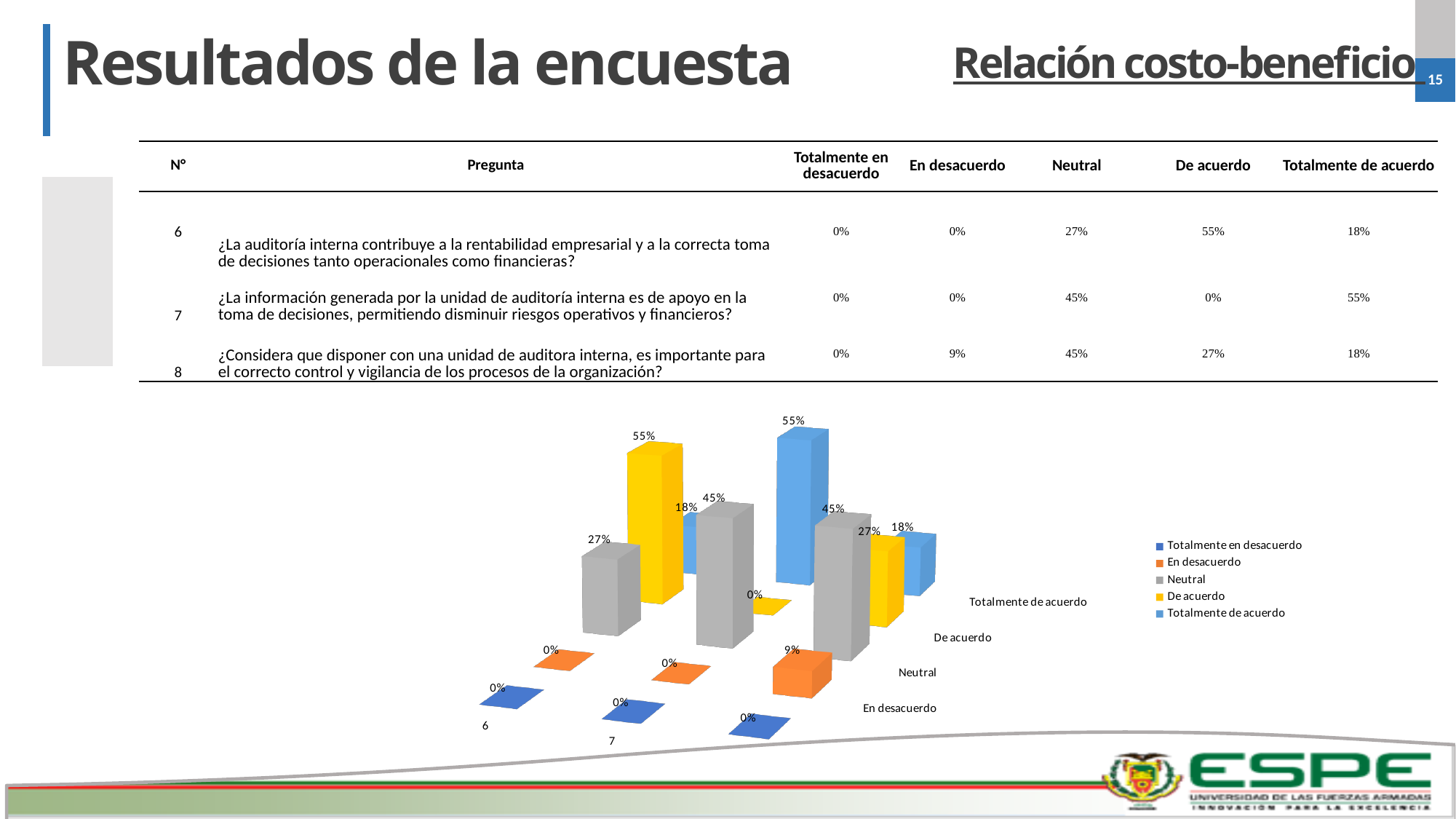
Which is larger in the chart: the De acuerdo value for question 6 or the De acuerdo value for question 8? De acuerdo for question 6 Which series has the highest value for question 8 in the chart? Neutral What is the value of the Neutral series for question 6 in the chart? 27% Which series in the chart legend is shown in yellow? De acuerdo What is the value of the En desacuerdo series for question 8 in the chart? 9% Which series has the highest value for question 7 in the chart? Totalmente de acuerdo What is the difference between the Neutral value for question 7 and the Neutral value for question 6 in the chart? 18% What kind of chart is shown on the slide? bar chart What is the value of the De acuerdo series for question 6 in the chart? 55% How many series does the chart legend list? 5 How many question categories are plotted along the x axis of the chart? 3 What is the value of the Totalmente de acuerdo series for question 7 in the chart? 55%